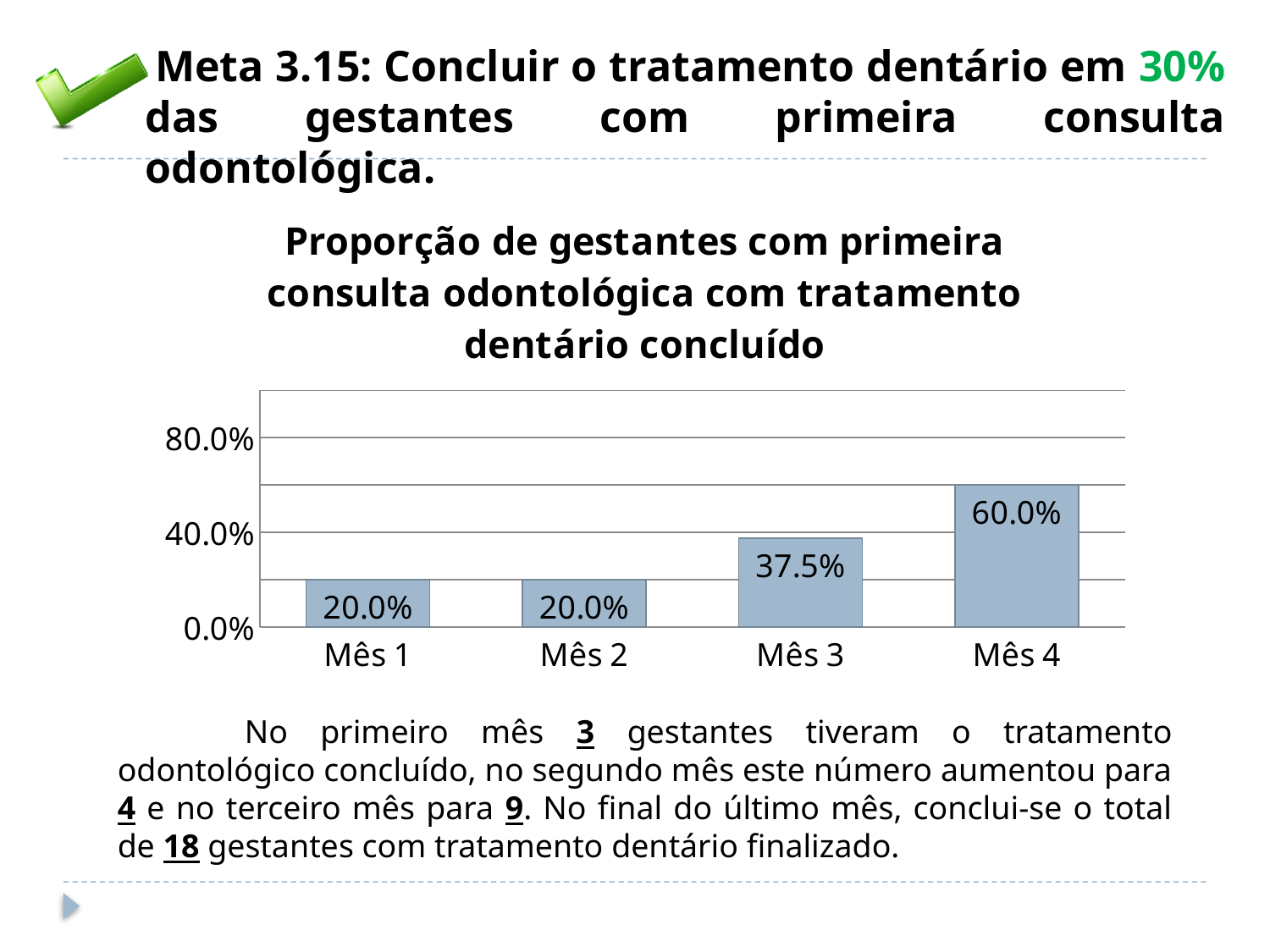
Which is larger, the value for Mês 3 or the value for Mês 4? Mês 4 What is the difference between the values for Mês 3 and Mês 2? 17.5% Is the value for Mês 4 greater or less than 40.0%? greater How many months are shown on the x axis? 4 What is the value for Mês 3? 37.5% What is the difference between the values for Mês 4 and Mês 3? 22.5% What is the value for Mês 4? 60.0% Do the values rise or fall from Mês 1 to Mês 4? rise What is the value for Mês 1? 20.0% Which month has the highest value? Mês 4 Is the value for Mês 1 greater or less than 40.0%? less What kind of chart is shown? bar chart